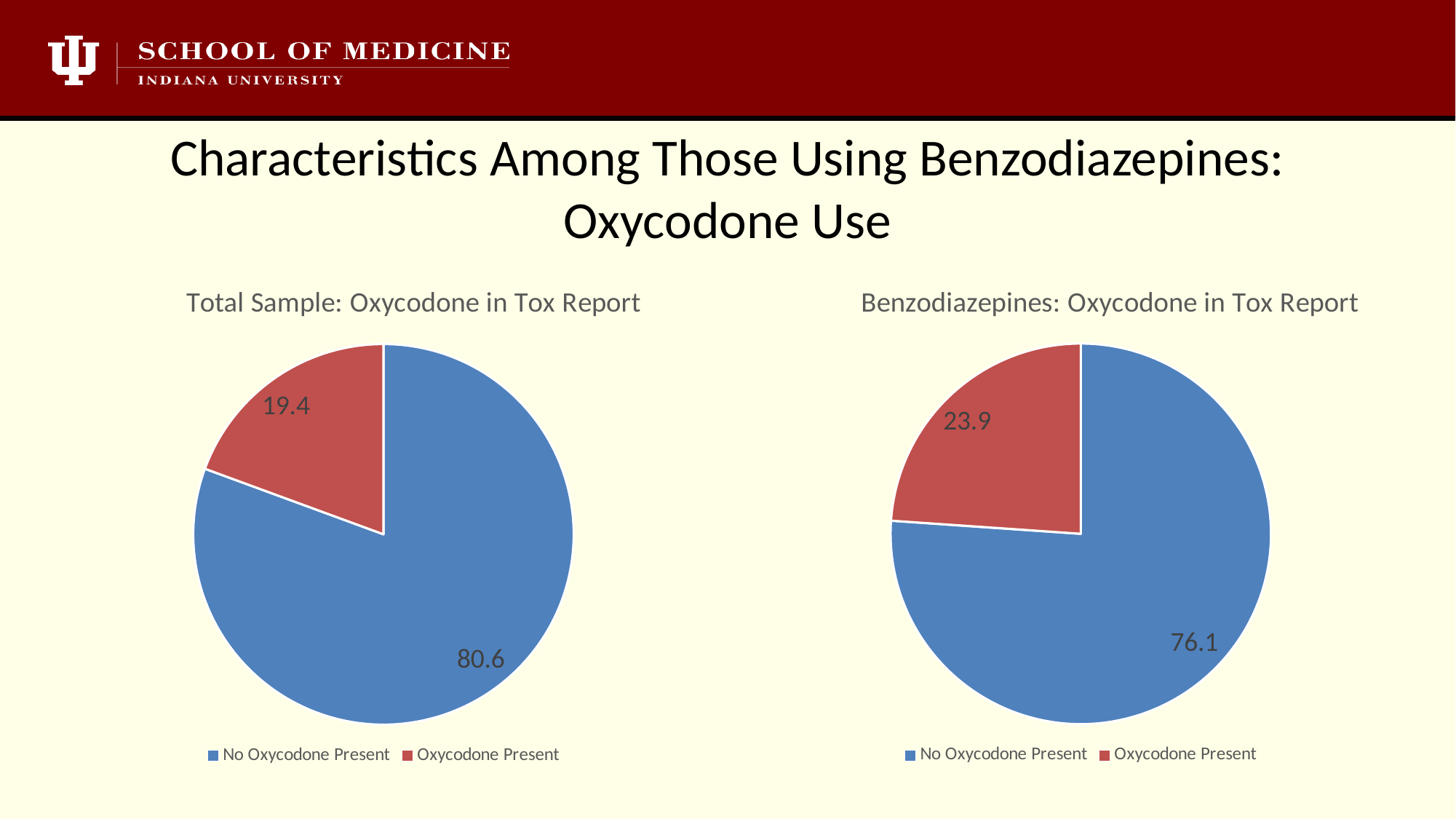
What kind of chart is the 'Total Sample: Oxycodone in Tox Report' chart? Pie chart In the 'Total Sample: Oxycodone in Tox Report' chart, which slice is the largest? No Oxycodone Present In the 'Benzodiazepines: Oxycodone in Tox Report' chart, which slice is the smallest? Oxycodone Present How many slices does the 'Benzodiazepines: Oxycodone in Tox Report' pie chart have? 2 In the 'Benzodiazepines: Oxycodone in Tox Report' chart, what is the value for 'Oxycodone Present'? 23.9 In the 'Total Sample: Oxycodone in Tox Report' chart, what is the value for 'Oxycodone Present'? 19.4 In the 'Total Sample: Oxycodone in Tox Report' chart, what colour is the 'Oxycodone Present' slice? Red In the 'Benzodiazepines: Oxycodone in Tox Report' chart, what is the value for 'No Oxycodone Present'? 76.1 In the 'Total Sample: Oxycodone in Tox Report' chart, what is the difference between the 'No Oxycodone Present' and 'Oxycodone Present' values? 61.2 In the 'Total Sample: Oxycodone in Tox Report' chart, what is the value for 'No Oxycodone Present'? 80.6 Is the 'Oxycodone Present' value larger in the 'Total Sample: Oxycodone in Tox Report' chart or in the 'Benzodiazepines: Oxycodone in Tox Report' chart? Benzodiazepines: Oxycodone in Tox Report In the 'Benzodiazepines: Oxycodone in Tox Report' chart, what is the difference between the 'No Oxycodone Present' and 'Oxycodone Present' values? 52.2